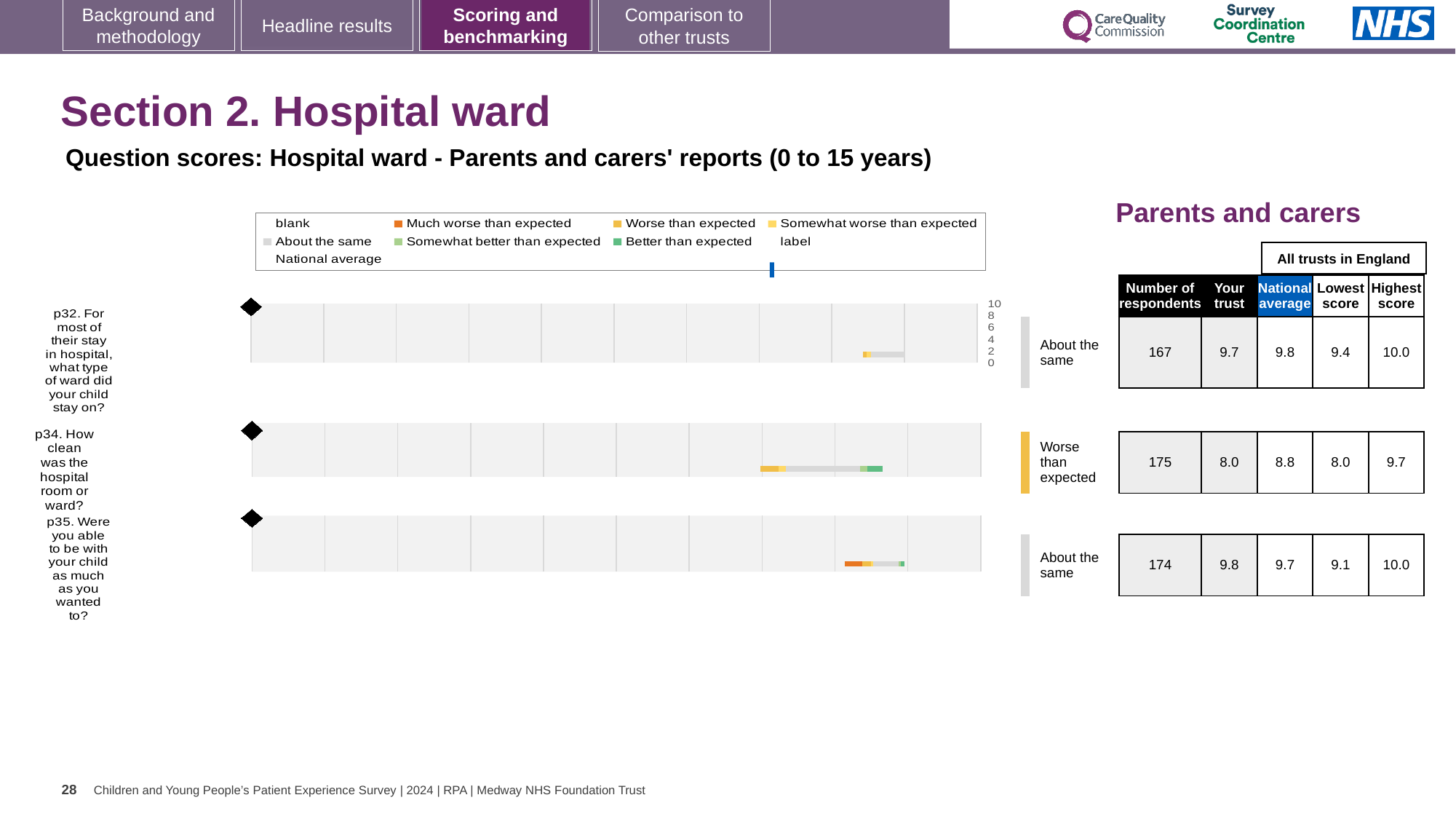
How many respondents answered p35 (Were you able to be with your child as much as you wanted to)? 174 Which question has the highest 'Your trust' score? p35 What kind of chart is used to show the question scores on this slide? bar chart How many questions (p32, p34, p35) are plotted in the charts on this slide? 3 What is the national average score for p32 (what type of ward did your child stay on)? 9.8 What benchmark category is shown next to the chart for p34? Worse than expected For p32, which is larger: the 'Your trust' score or the national average? National average How many more respondents answered p34 than p32? 8 What is the 'Your trust' score for p34 (How clean was the hospital room or ward?)? 8.0 Which question has the lowest 'Your trust' score? p34 For p34, what is the difference between the highest score and the lowest score among all trusts in England? 1.7 What is the lowest score among all trusts in England for p35? 9.1